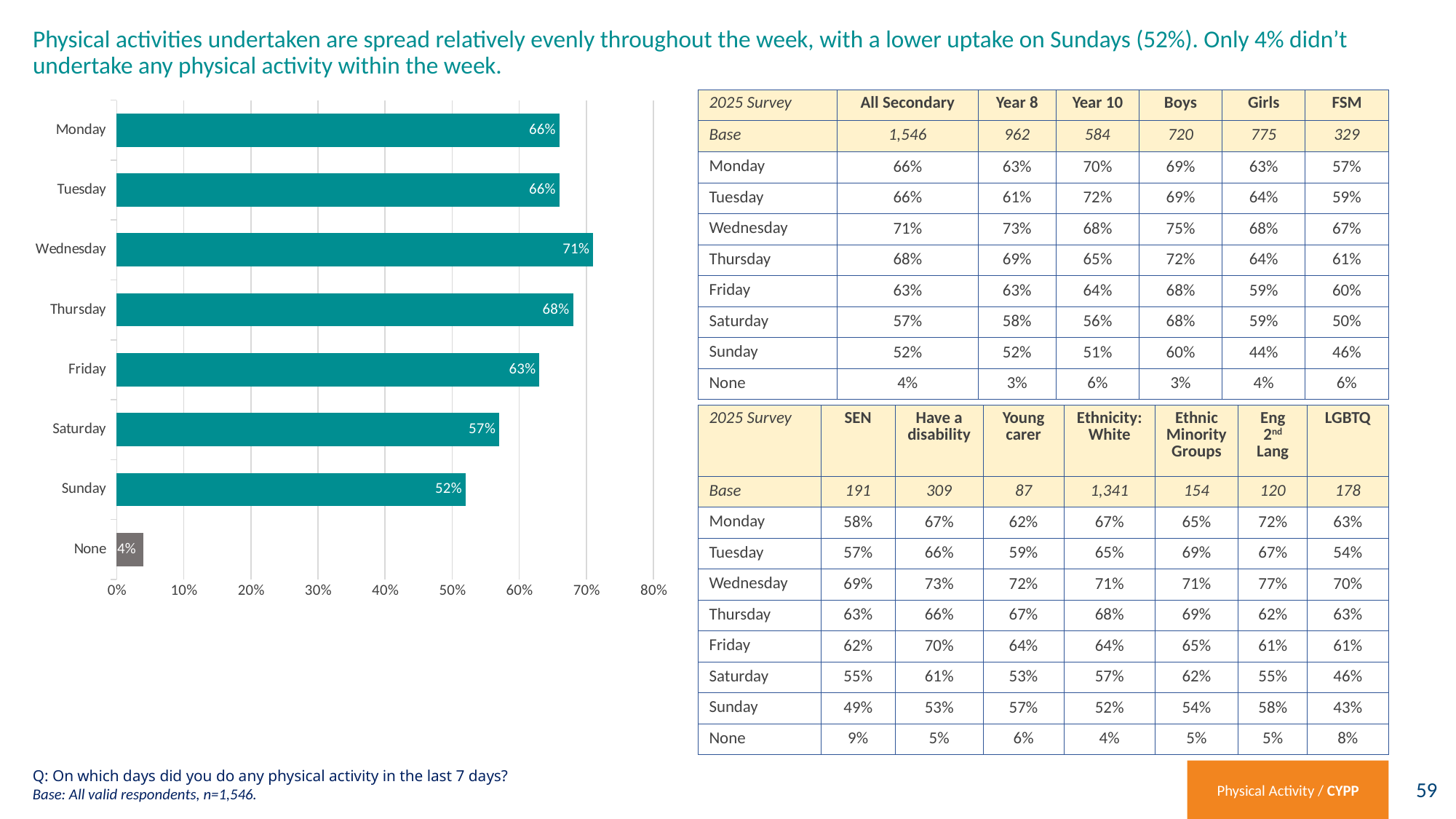
What kind of chart is shown on the slide? bar chart What is the value for Wednesday in the bar chart? 71% What is the difference between the values for Monday and Friday in the bar chart? 3% How many categories are shown in the bar chart? 8 What is the highest value shown on the x axis of the bar chart? 80% Which day of the week has the highest value in the bar chart? Wednesday Is the value for Saturday in the bar chart greater or less than 60%? less Which is larger in the bar chart, the value for Thursday or the value for Friday? Thursday What is the difference between the values for Wednesday and Sunday in the bar chart? 19% What is the value for None in the bar chart? 4% Which category has the lowest value in the bar chart? None What is the value for Sunday in the bar chart? 52%